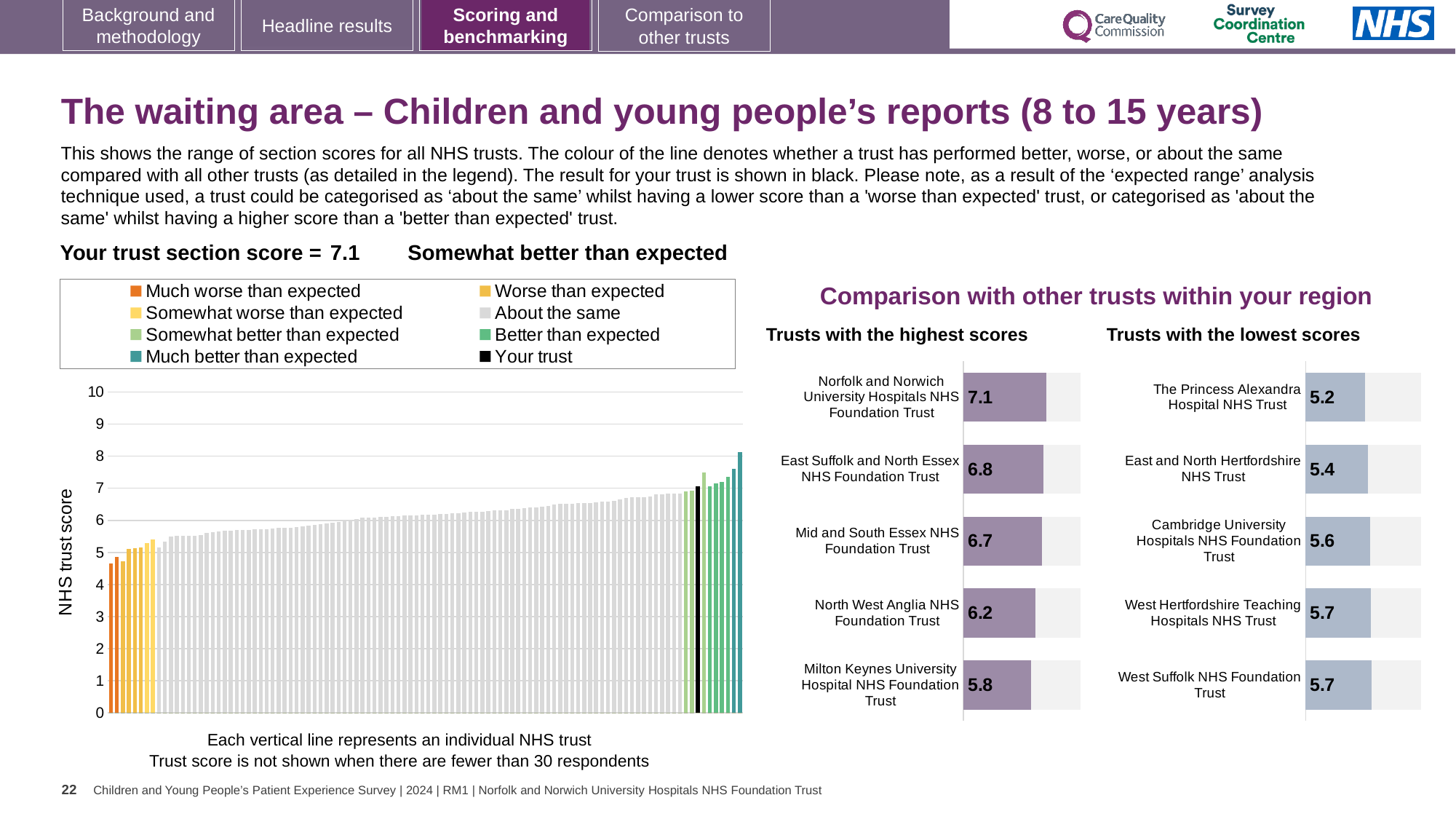
In the 'Trusts with the highest scores' chart, what is the score for East Suffolk and North Essex NHS Foundation Trust? 6.8 In the 'Trusts with the highest scores' chart, what is the difference between the scores of Norfolk and Norwich University Hospitals NHS Foundation Trust and Milton Keynes University Hospital NHS Foundation Trust? 1.3 In the 'Trusts with the highest scores' chart, which has the higher score: Mid and South Essex NHS Foundation Trust or North West Anglia NHS Foundation Trust? Mid and South Essex NHS Foundation Trust In the 'Trusts with the lowest scores' chart, what is the score for Cambridge University Hospitals NHS Foundation Trust? 5.6 What kind of chart is the large chart on the left with the 'NHS trust score' axis? bar chart How many entries does the legend above the 'NHS trust score' chart list? 8 In the large 'NHS trust score' chart on the left, is the value of the leftmost (lowest) bar greater or less than 5? less In the 'Trusts with the highest scores' chart, which trust has the highest score? Norfolk and Norwich University Hospitals NHS Foundation Trust In the large 'NHS trust score' chart on the left, do the bar values rise or fall from left to right? rise In the 'Trusts with the lowest scores' chart, what is the difference between the scores of East and North Hertfordshire NHS Trust and The Princess Alexandra Hospital NHS Trust? 0.2 How many trusts are shown in the 'Trusts with the lowest scores' chart? 5 In the 'Trusts with the lowest scores' chart, which trust has the lowest score? The Princess Alexandra Hospital NHS Trust